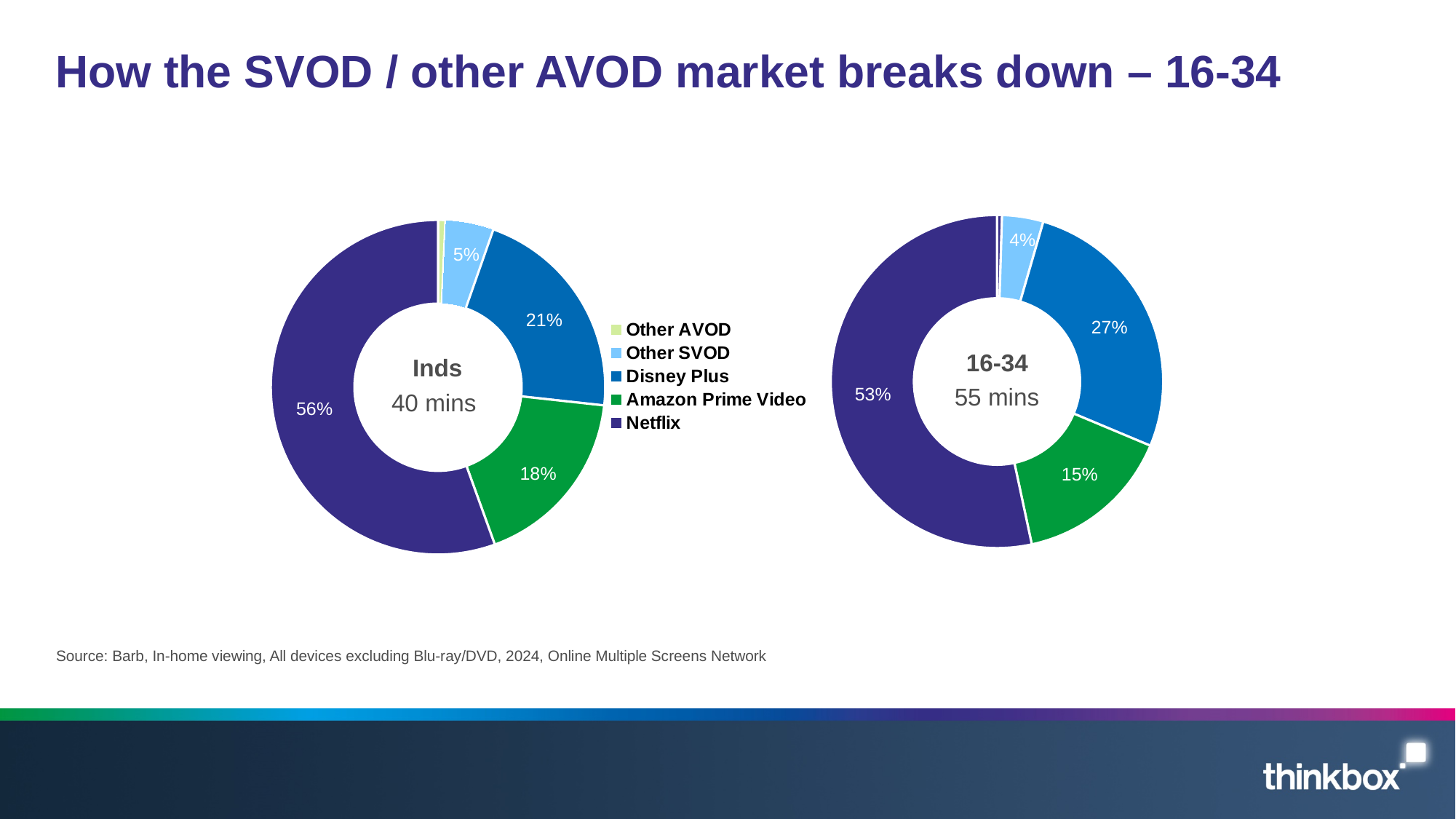
In the 16-34 chart, which category has the largest share? Netflix In the 16-34 chart, what share does Amazon Prime Video have? 15% In the Inds chart, which category has the smallest share? Other AVOD What kind of chart is used on this slide? Pie (donut) chart What is the difference between Netflix's share in the Inds chart and in the 16-34 chart? 3 percentage points In the Inds chart, what share does Other SVOD have? 5% In the Inds chart, what share does Netflix have? 56% What viewing time is shown in the centre of the 16-34 chart? 55 mins In the Inds chart, which is larger: Disney Plus or Amazon Prime Video? Disney Plus In the 16-34 chart, what share does Disney Plus have? 27% Is Disney Plus's share larger in the Inds chart or in the 16-34 chart? 16-34 How many categories does the legend list? 5